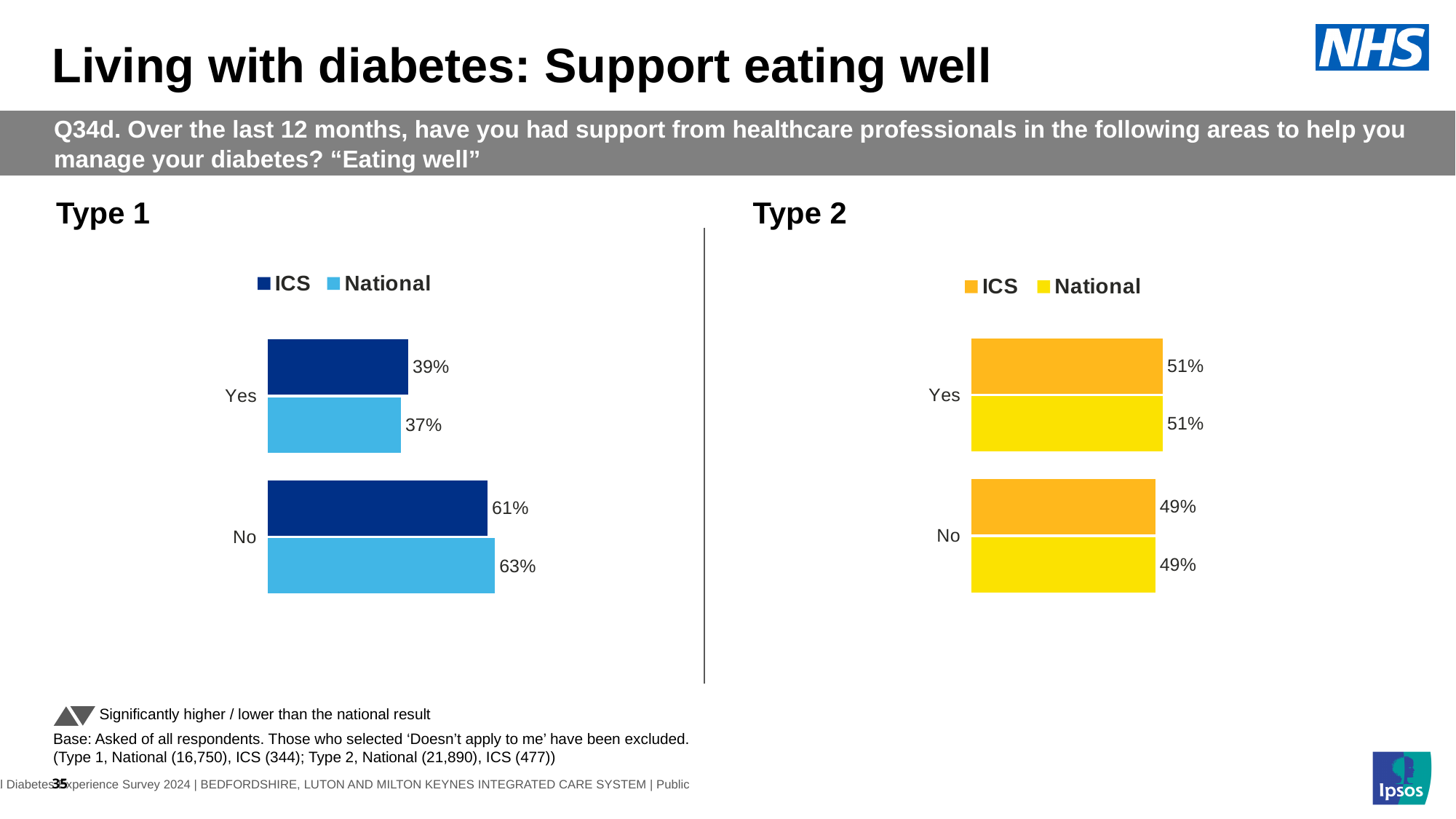
In the Type 1 chart, what is the difference between the National and ICS values for No? 2% How many categories are shown in the Type 1 chart? 2 In the Type 2 chart, which category has the higher ICS value, Yes or No? Yes In the Type 1 chart, which category has the lowest National value? Yes What kind of chart is the Type 1 chart? Bar chart In the Type 2 chart, what is the National value for No? 49% How many series does the legend of the Type 2 chart list? 2 In the Type 1 chart, which is larger for Yes, the ICS value or the National value? ICS In the Type 1 chart, what is the National value for No? 63% In the Type 2 chart, what colour represents the National series? Yellow In the Type 1 chart, what is the ICS value for Yes? 39% In the Type 2 chart, what is the ICS value for Yes? 51%